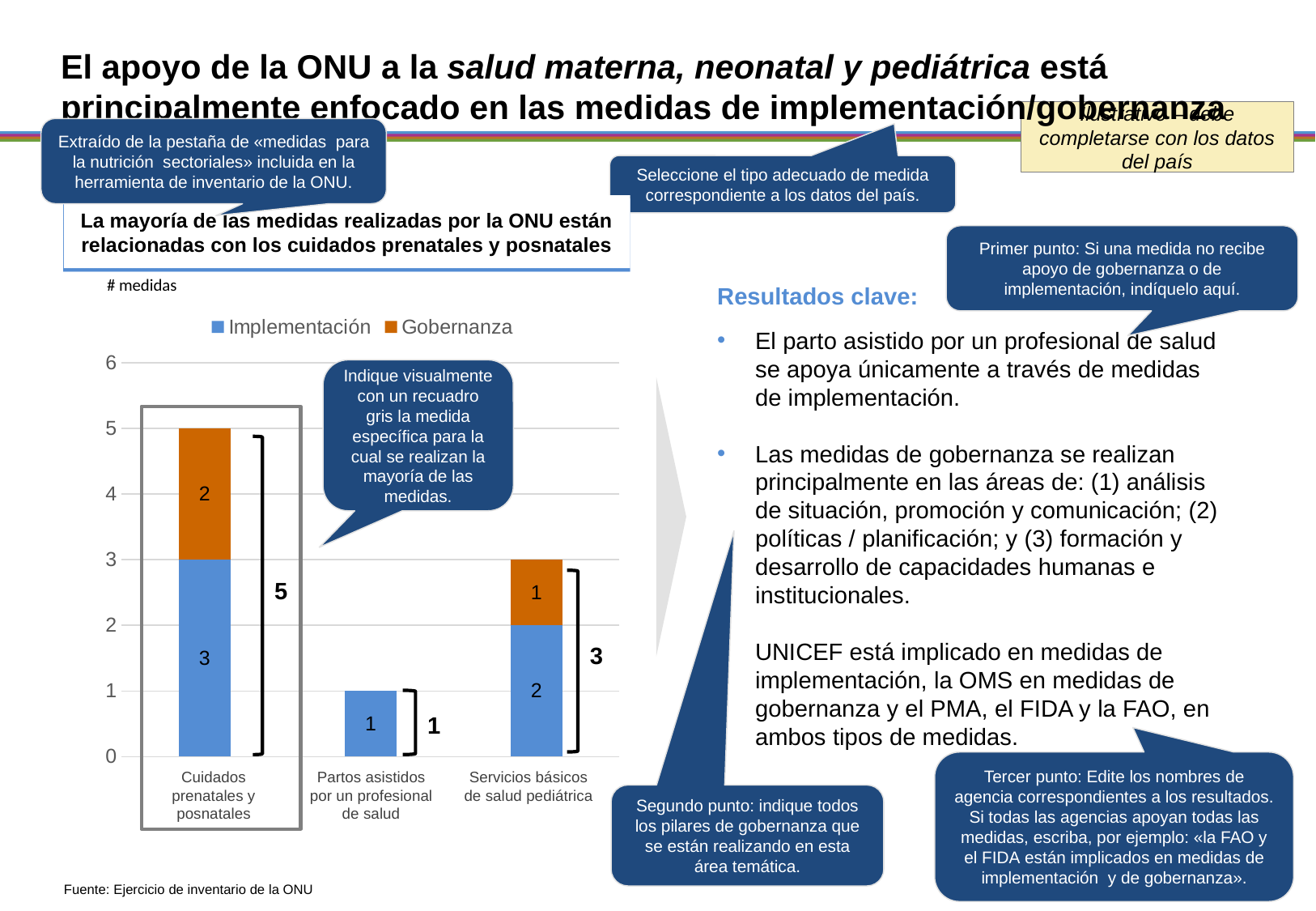
What is the Gobernanza value for Cuidados prenatales y posnatales? 2 How many series does the chart legend list? 2 What is the total number of measures for the Servicios básicos de salud pediátrica bar? 3 What is the Gobernanza value for Servicios básicos de salud pediátrica? 1 What is the total number of measures for the Cuidados prenatales y posnatales bar? 5 Which category has the highest total number of measures? Cuidados prenatales y posnatales What is the Implementación value for Cuidados prenatales y posnatales? 3 How many categories are shown on the x axis of the chart? 3 What is the Implementación value for Partos asistidos por un profesional de salud? 1 What is the difference between the Implementación values for Cuidados prenatales y posnatales and Servicios básicos de salud pediátrica? 1 Which category has the lowest total number of measures? Partos asistidos por un profesional de salud What type of chart is shown on the slide? Stacked bar chart